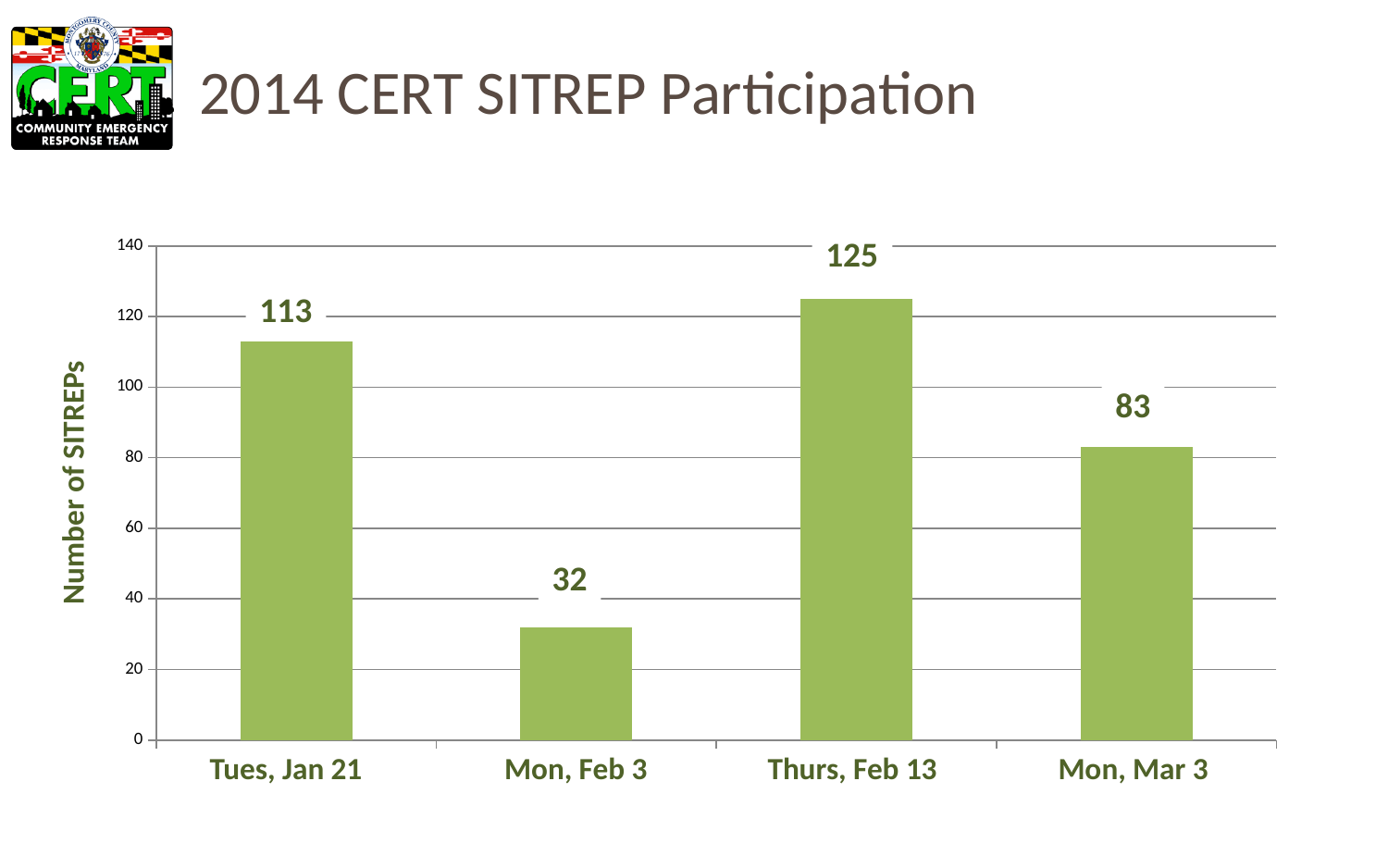
How many dates are shown on the x axis of the chart? 4 What is the label of the vertical axis? Number of SITREPs What type of chart is shown on the slide? Bar chart Which date has the highest number of SITREPs? Thurs, Feb 13 Which has more SITREPs, Tues, Jan 21 or Mon, Mar 3? Tues, Jan 21 How many SITREPs were recorded for Tues, Jan 21? 113 What value is shown for Thurs, Feb 13? 125 How many SITREPs were recorded for Mon, Mar 3? 83 Which date has the lowest number of SITREPs? Mon, Feb 3 What is the difference in SITREPs between Thurs, Feb 13 and Mon, Feb 3? 93 What is the difference in SITREPs between Tues, Jan 21 and Mon, Mar 3? 30 What is the number of SITREPs for Mon, Feb 3? 32